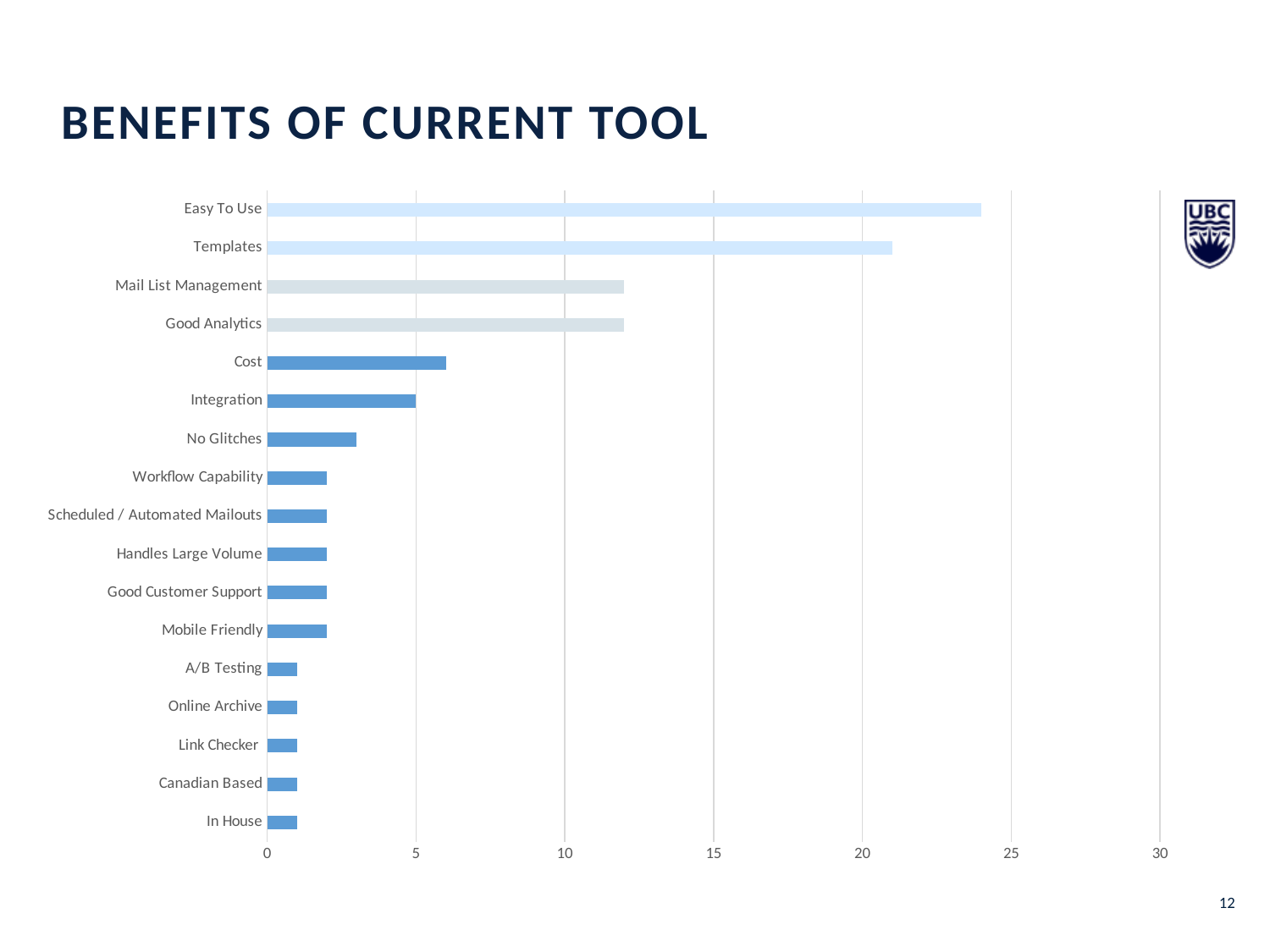
Which is larger, the value for Cost or the value for No Glitches? Cost What kind of chart is shown on the slide? bar chart Is the value for Cost greater or less than 5? greater How many categories are plotted in the chart? 17 What is the title of the slide containing the chart? BENEFITS OF CURRENT TOOL Is the value for Mail List Management greater or less than 10? greater Which category has the highest value? Easy To Use Is the value for Easy To Use greater or less than 20? greater Which is larger, the value for Easy To Use or the value for Templates? Easy To Use